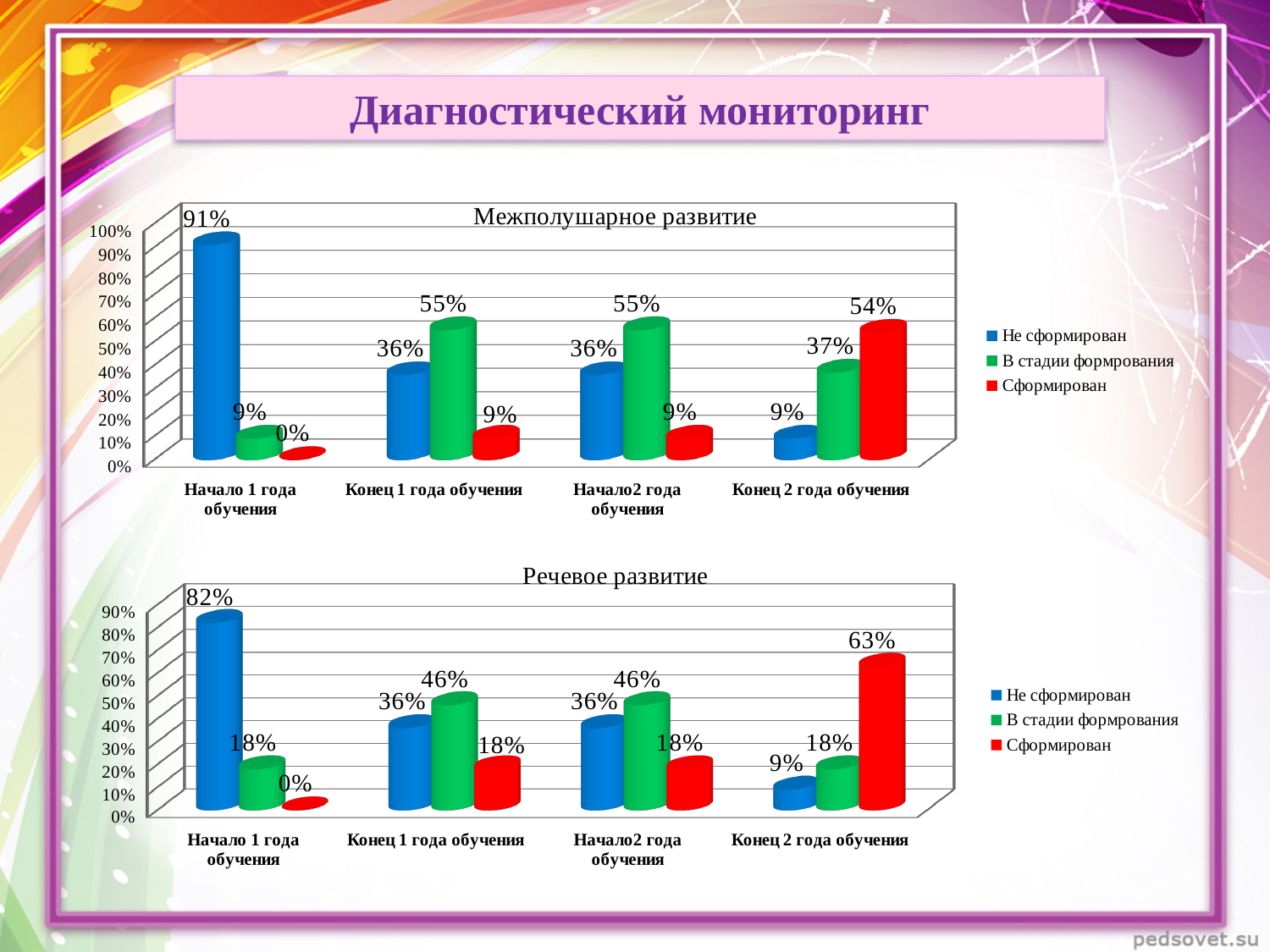
In the "Речевое развитие" chart, what is the value of "Сформирован" for "Конец 2 года обучения"? 63% In the "Межполушарное развитие" chart, what is the difference between "Не сформирован" at "Начало 1 года обучения" and at "Конец 2 года обучения"? 82% In the "Межполушарное развитие" chart, what is the value of "Сформирован" for "Конец 2 года обучения"? 54% How many categories are shown on the x axis of the "Речевое развитие" chart? 4 How many series does the legend of the "Межполушарное развитие" chart list? 3 In the "Речевое развитие" chart, which is larger for "Конец 2 года обучения": "Не сформирован" or "Сформирован"? Сформирован In the "Речевое развитие" chart, which category has the lowest value for "Сформирован"? Начало 1 года обучения In the "Речевое развитие" chart, what is the difference between "Сформирован" at "Конец 2 года обучения" and at "Начало2 года обучения"? 45% In the "Межполушарное развитие" chart, does the value of "Не сформирован" rise or fall from "Начало 1 года обучения" to "Конец 2 года обучения"? fall In the "Межполушарное развитие" chart, which category has the highest value for "Не сформирован"? Начало 1 года обучения In the "Межполушарное развитие" chart, what is the value of "Не сформирован" for "Начало 1 года обучения"? 91% In the "Речевое развитие" chart, what is the value of "В стадии формирования" for "Конец 1 года обучения"? 46%